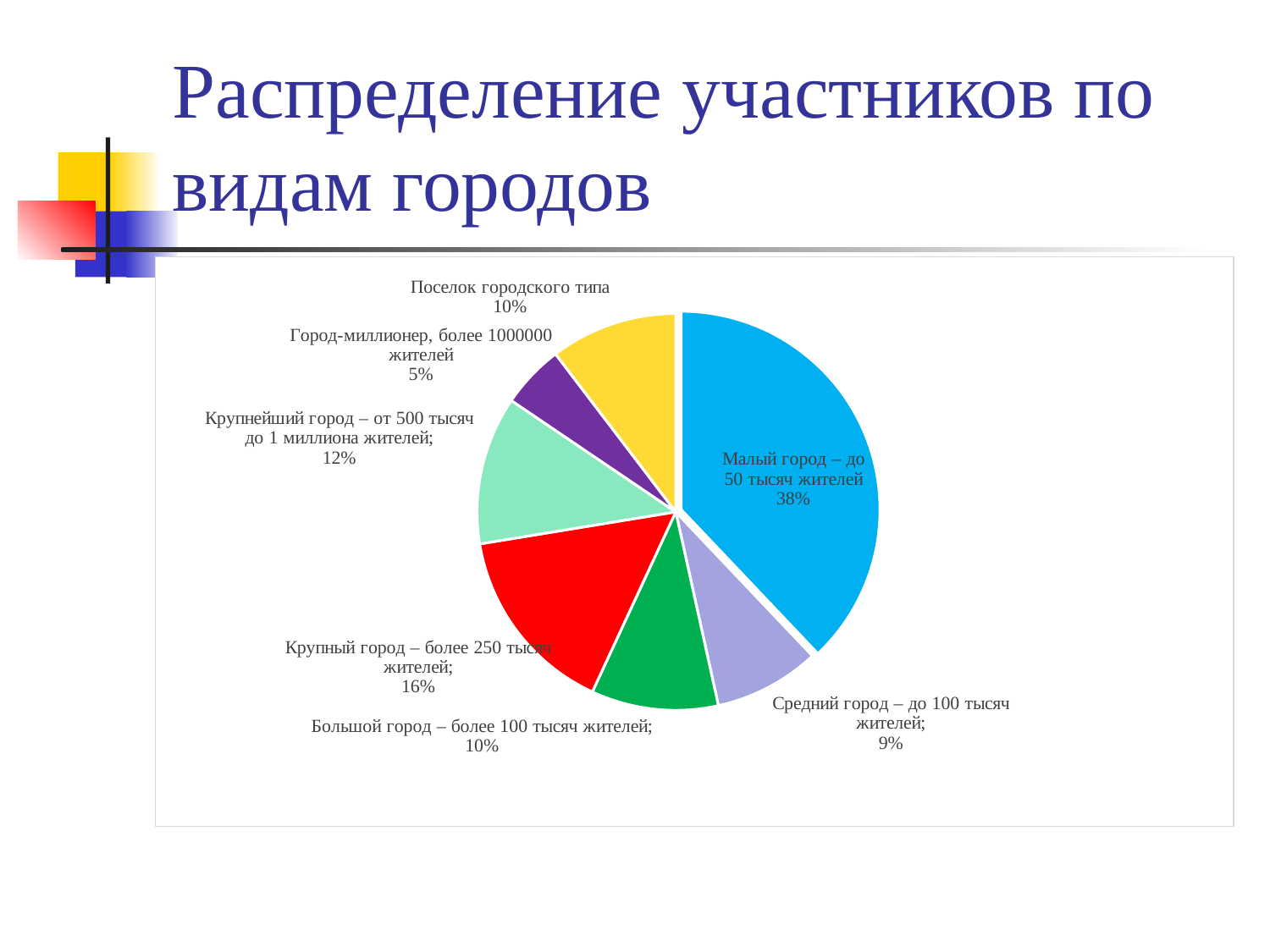
Which category has the smallest share of participants? Город-миллионер, более 1000000 жителей What is the difference in percentage points between "Малый город – до 50 тысяч жителей" and "Крупный город – более 250 тысяч жителей"? 22 How many categories (slices) does the pie chart have? 7 What share of participants is from "Город-миллионер, более 1000000 жителей"? 5% What share of participants is from "Малый город – до 50 тысяч жителей"? 38% What share of participants is from "Поселок городского типа"? 10% What share of participants is from "Средний город – до 100 тысяч жителей"? 9% Which has a larger share: "Крупнейший город – от 500 тысяч до 1 миллиона жителей" or "Средний город – до 100 тысяч жителей"? Крупнейший город – от 500 тысяч до 1 миллиона жителей What share of participants is from "Крупный город – более 250 тысяч жителей"? 16% What is the title of the slide containing the chart? Распределение участников по видам городов What type of chart is shown on the slide? pie chart Which category has the largest share of participants? Малый город – до 50 тысяч жителей